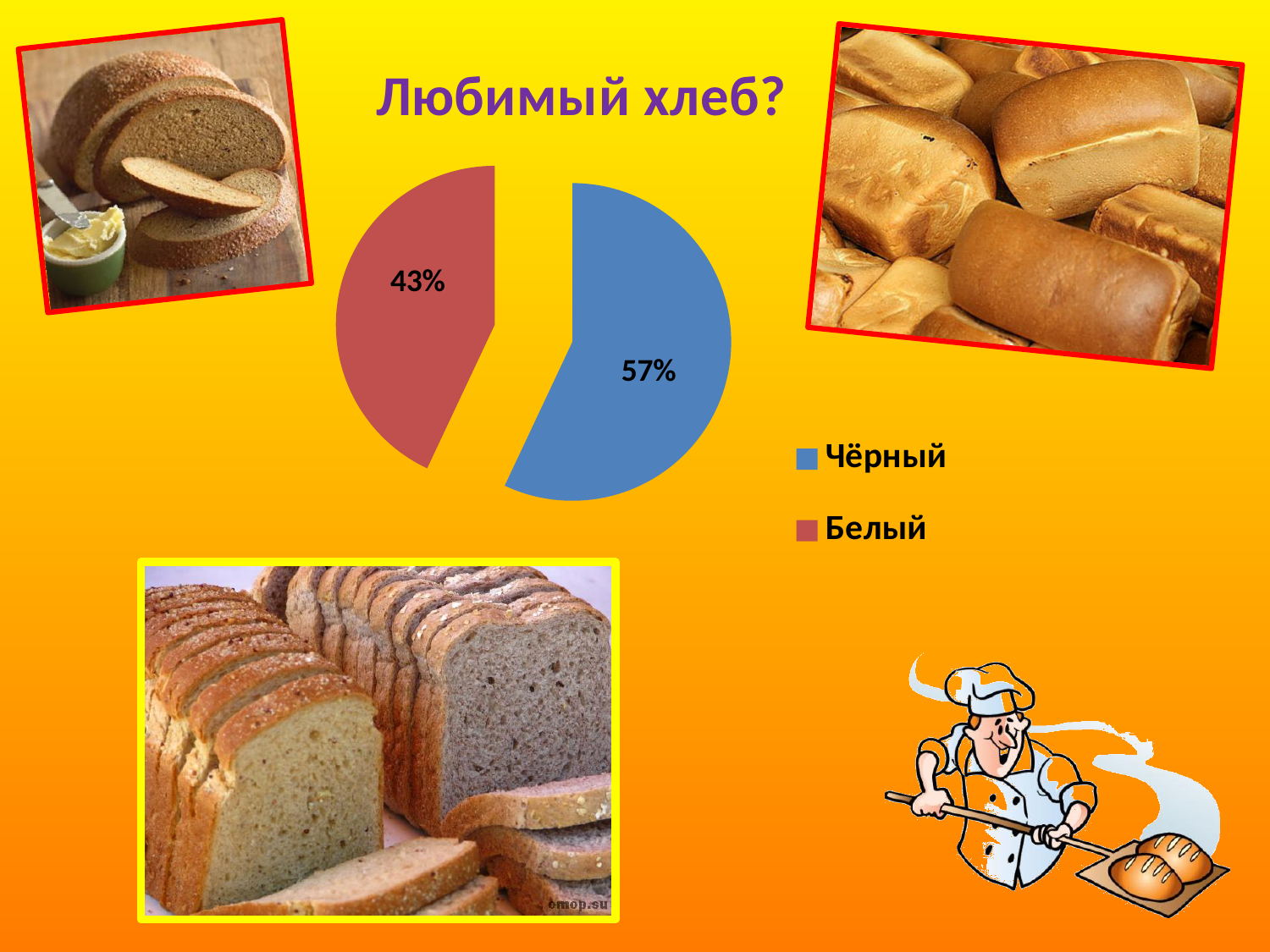
Is the share for Чёрный greater or less than 50%? greater What share of the pie does Чёрный have? 57% What colour is the slice for Белый? red How many slices does the pie chart have? 2 What is the title of the chart? Любимый хлеб? What kind of chart is shown on the slide? pie chart Which category has the largest slice of the pie? Чёрный What is the difference in percentage points between Чёрный and Белый? 14 What share of the pie does Белый have? 43% Which is larger, the share for Чёрный or the share for Белый? Чёрный Which category has the smallest slice of the pie? Белый How many entries does the legend list? 2